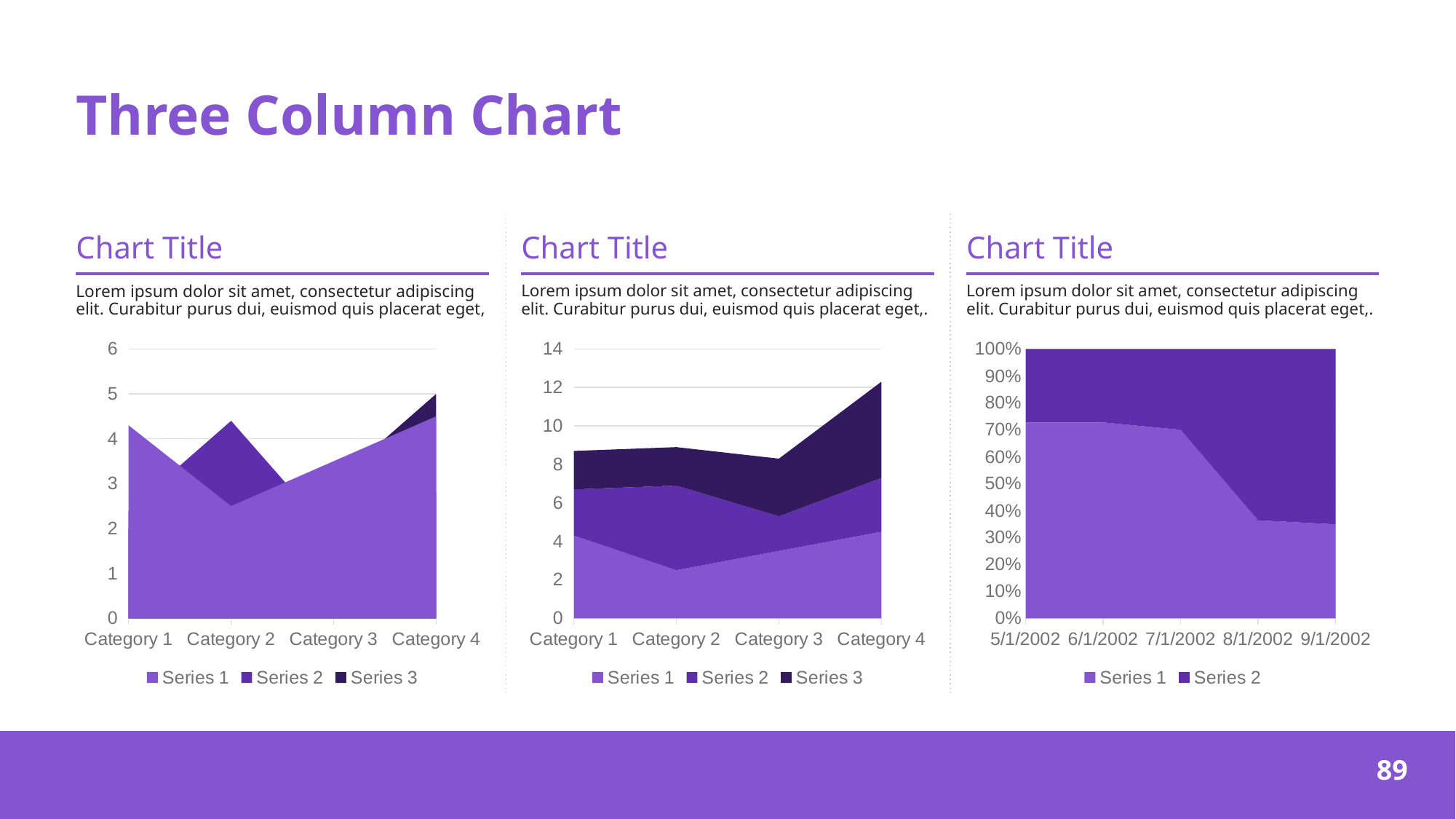
In the middle chart, is the stacked total at Category 4 greater or less than 10? greater In the middle chart, is the value for Series 1 at Category 2 greater or less than 4? less How many series does the legend of the left chart list? 3 In the right chart, is the share for Series 1 at 9/1/2002 greater or less than 50%? less What kind of chart is the left chart on the slide? area chart How many series does the legend of the right chart list? 2 In the right chart, does the share for Series 1 rise or fall from 5/1/2002 to 9/1/2002? fall How many dates are shown on the x axis of the right chart? 5 How many series does the legend of the middle chart list? 3 How many categories are shown on the x axis of the left chart? 4